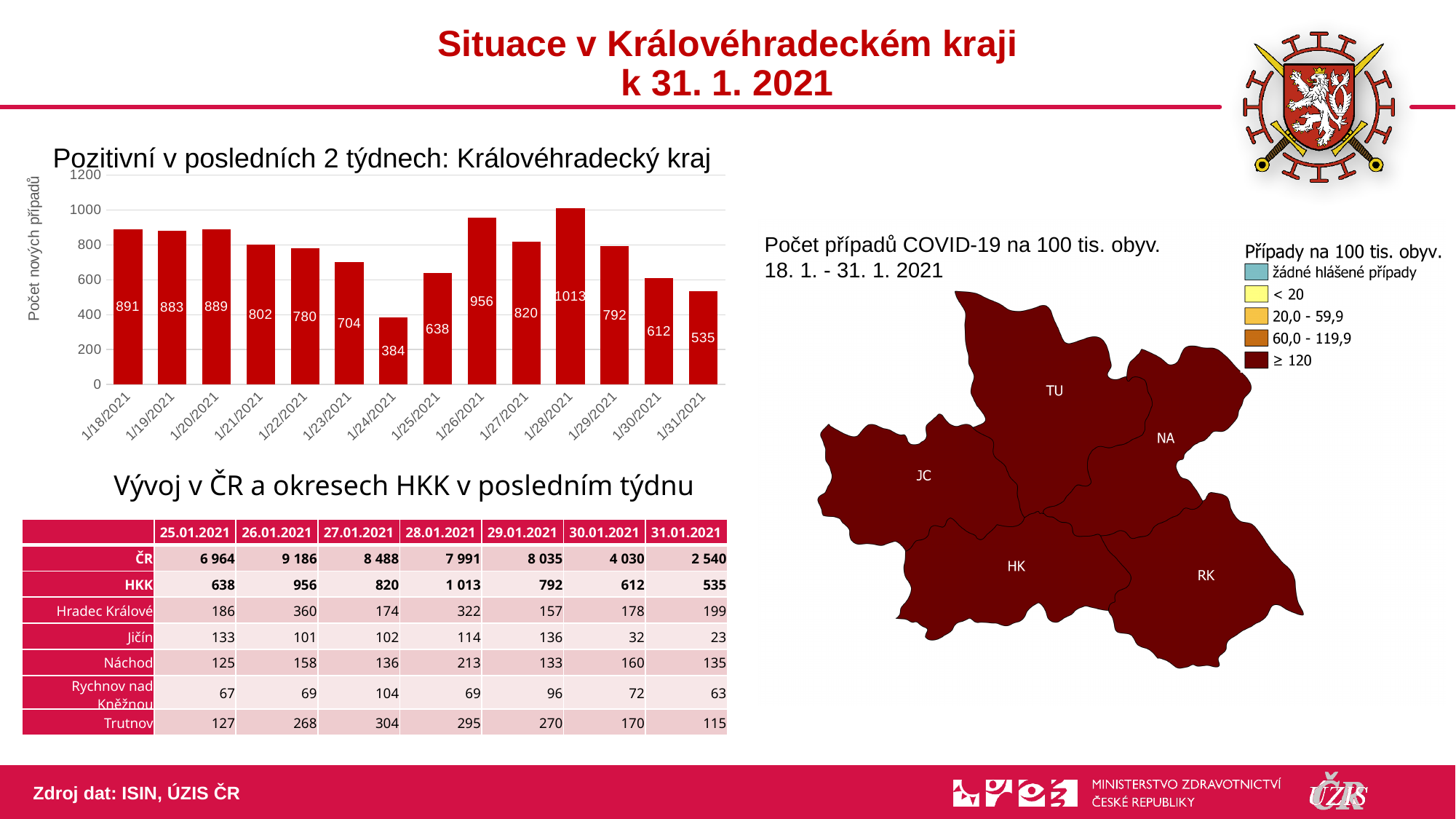
In the bar chart, what is the difference between the values for 1/28/2021 and 1/24/2021? 629 In the bar chart, is the value for 1/31/2021 greater or less than 600? less What type of chart is used for 'Pozitivní v posledních 2 týdnech: Královéhradecký kraj'? bar chart What is the label of the y axis of the bar chart? Počet nových případů In the bar chart, what is the difference between the values for 1/26/2021 and 1/25/2021? 318 In the bar chart, what is the value for 1/24/2021? 384 Which date has the highest value in the bar chart? 1/28/2021 In the bar chart, what is the value for 1/28/2021? 1013 Which date has the lowest value in the bar chart? 1/24/2021 In the bar chart, which is larger: the value for 1/26/2021 or the value for 1/27/2021? 1/26/2021 How many dates are shown on the x axis of the bar chart? 14 In the bar chart, what is the value for 1/31/2021? 535